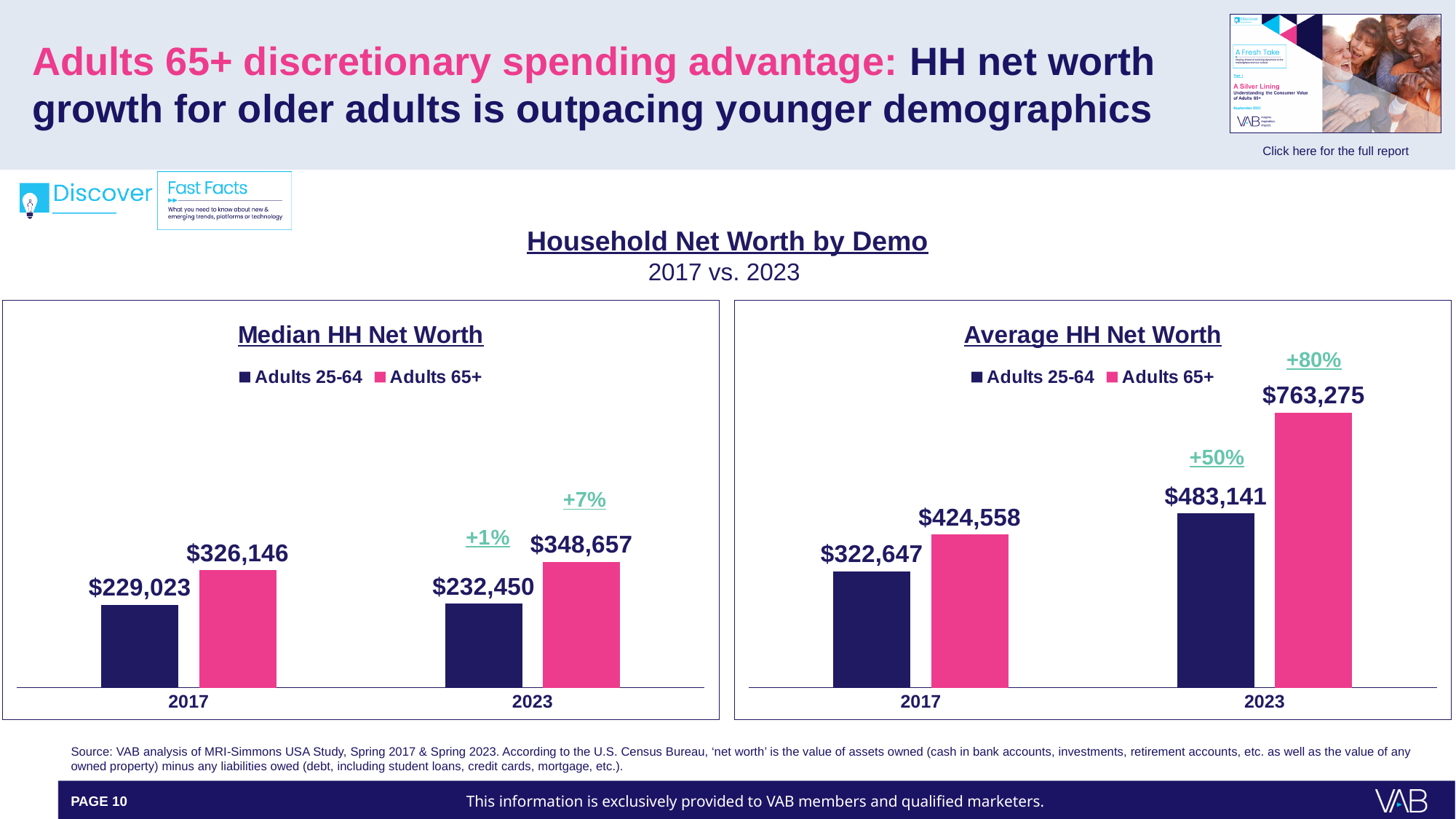
In the Average HH Net Worth chart, what is the difference between Adults 65+ and Adults 25-64 in 2023? $280,134 In the Median HH Net Worth chart, which bar is the lowest? Adults 25-64 in 2017 In the Average HH Net Worth chart, what percentage growth is shown above the Adults 65+ bar for 2023? +80% In the Average HH Net Worth chart, what is the value for Adults 65+ in 2023? $763,275 In the Median HH Net Worth chart, which is larger: Adults 65+ in 2017 or Adults 25-64 in 2023? Adults 65+ in 2017 In the Average HH Net Worth chart, what is the value for Adults 25-64 in 2017? $322,647 In the Median HH Net Worth chart, what is the value for Adults 25-64 in 2017? $229,023 In the Median HH Net Worth chart, what is the difference between Adults 65+ and Adults 25-64 in 2023? $116,207 In the Median HH Net Worth chart, what percentage growth is shown above the Adults 25-64 bar for 2023? +1% In the Median HH Net Worth chart, what is the value for Adults 65+ in 2023? $348,657 In the Average HH Net Worth chart, which bar is the highest? Adults 65+ in 2023 How many series does the legend of the Average HH Net Worth chart list? 2